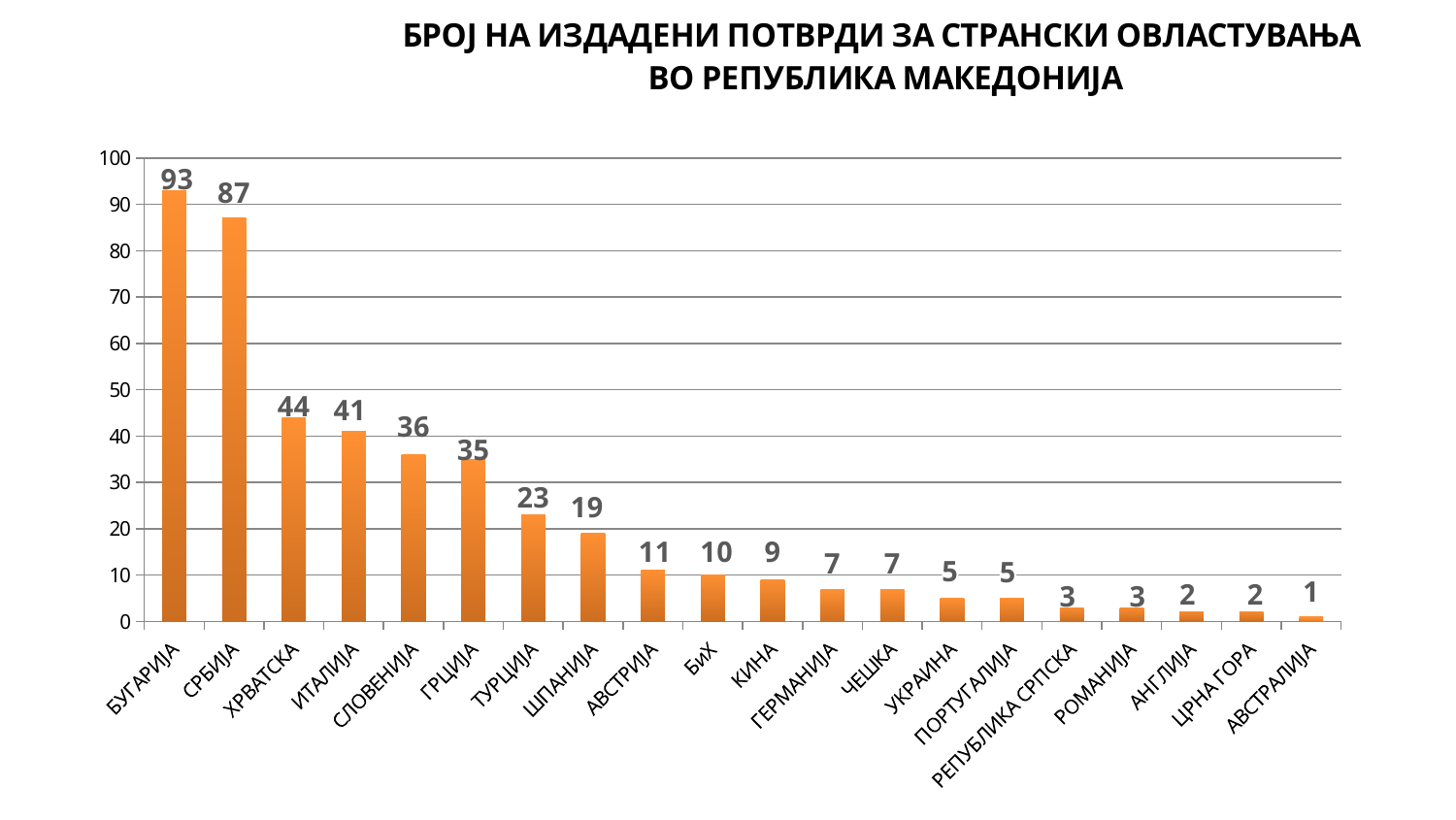
What kind of chart is shown on the slide? bar chart What is the value for ХРВАТСКА? 44 Do the values rise or fall from left to right along the x axis? fall How many categories are shown on the x axis? 20 What is the title of the chart? БРОЈ НА ИЗДАДЕНИ ПОТВРДИ ЗА СТРАНСКИ ОВЛАСТУВАЊА ВО РЕПУБЛИКА МАКЕДОНИЈА Is the value for ГРЦИЈА greater or less than 30? greater What is the value for БУГАРИЈА? 93 Which category has the highest value? БУГАРИЈА What is the difference between the values for БУГАРИЈА and СРБИЈА? 6 Which is larger, the value for ИТАЛИЈА or the value for СЛОВЕНИЈА? ИТАЛИЈА What is the value for ТУРЦИЈА? 23 Which category has the lowest value? АВСТРАЛИЈА